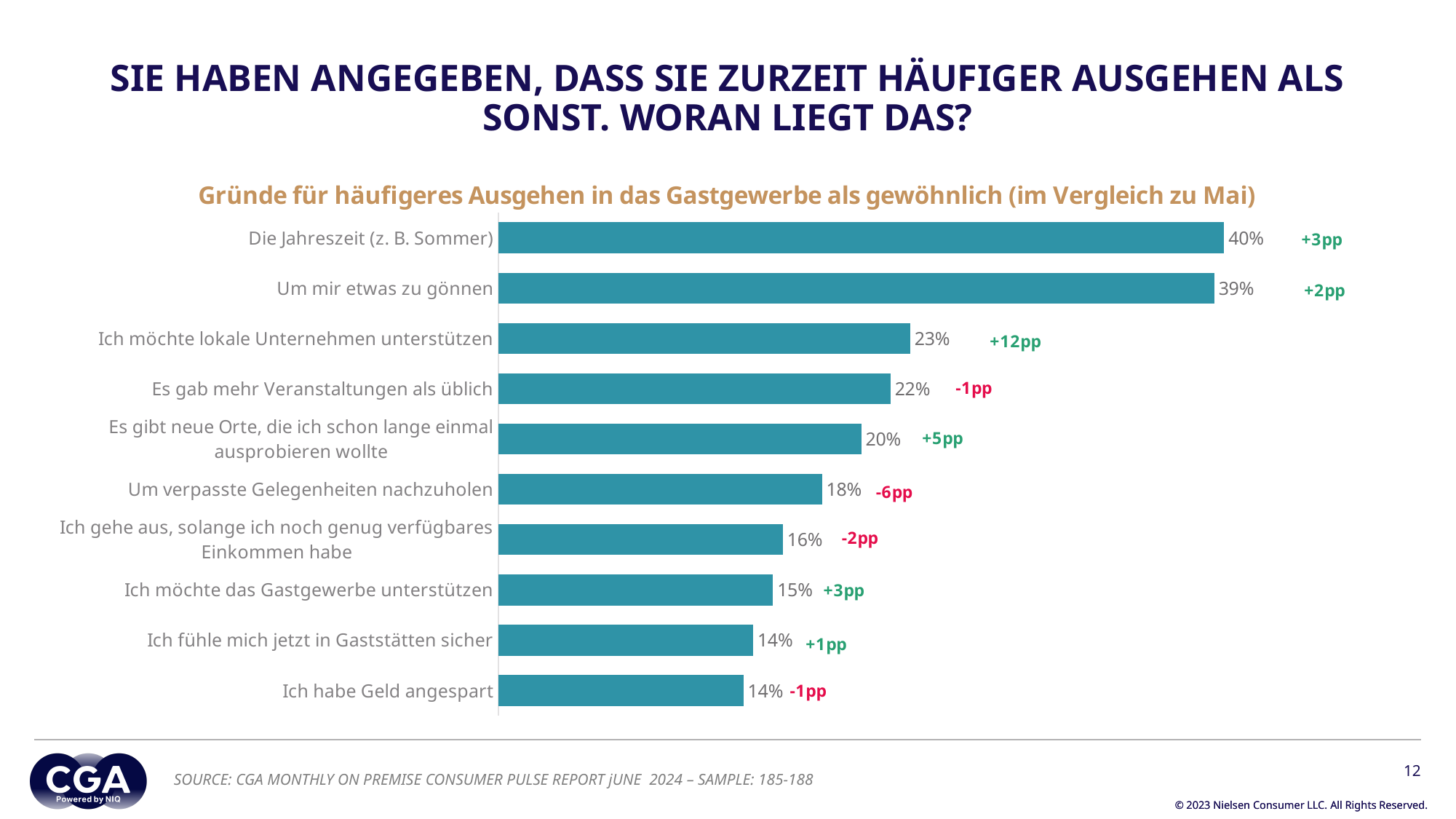
What is the change versus May shown for "Um verpasste Gelegenheiten nachzuholen"? -6pp Which is larger: the value for "Es gibt neue Orte, die ich schon lange einmal ausprobieren wollte" or the value for "Ich gehe aus, solange ich noch genug verfügbares Einkommen habe"? Es gibt neue Orte, die ich schon lange einmal ausprobieren wollte What is the value for "Die Jahreszeit (z. B. Sommer)"? 40% What is the change versus May shown for "Ich möchte lokale Unternehmen unterstützen"? +12pp What is the value for "Ich möchte das Gastgewerbe unterstützen"? 15% What is the difference between the values for "Um mir etwas zu gönnen" and "Es gab mehr Veranstaltungen als üblich"? 17% What is the value for "Ich möchte lokale Unternehmen unterstützen"? 23% What is the title of the chart? Gründe für häufigeres Ausgehen in das Gastgewerbe als gewöhnlich (im Vergleich zu Mai) What kind of chart is shown on the slide? Bar chart How many categories are shown in the chart? 10 What is the value for "Um verpasste Gelegenheiten nachzuholen"? 18% Which category has the highest value? Die Jahreszeit (z. B. Sommer)